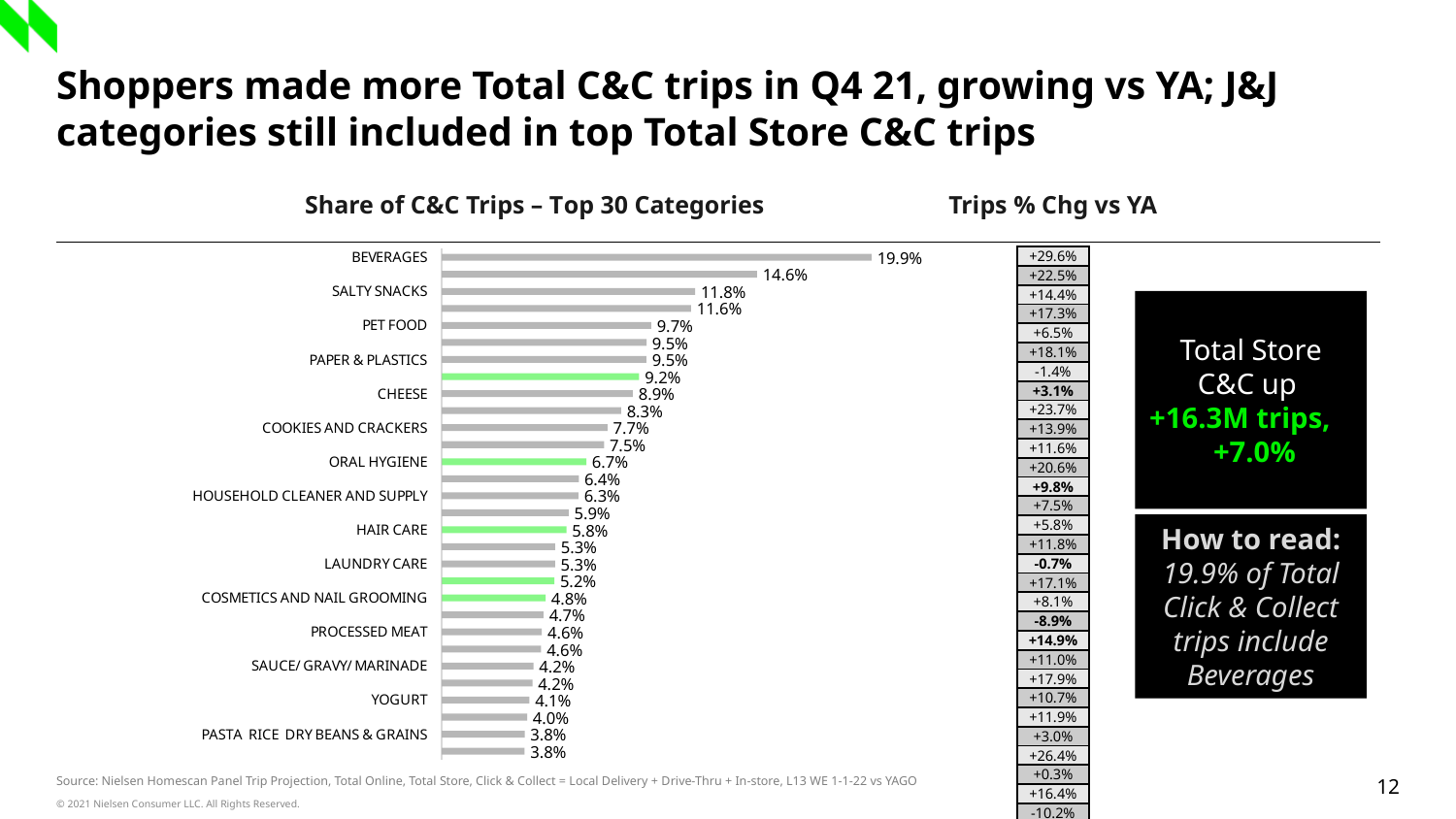
Which has a larger share of C&C trips, Pet Food or Cheese? Pet Food What is the share of C&C trips for Oral Hygiene? 6.7% What is the lowest share value shown on the chart? 3.8% How much larger is the share for Beverages than for Salty Snacks, in percentage points? 8.1 What is the share of C&C trips for Salty Snacks? 11.8% What is the share of C&C trips for Beverages? 19.9% Do the bar values increase or decrease going from the top of the chart to the bottom? Decrease What type of chart is used to show the Share of C&C Trips – Top 30 Categories? Bar chart Which category has the highest share of C&C trips? Beverages How many categories are plotted in the Share of C&C Trips chart? 30 What is the share of C&C trips for Pasta Rice Dry Beans & Grains? 3.8% What is the share of C&C trips for Hair Care? 5.8%